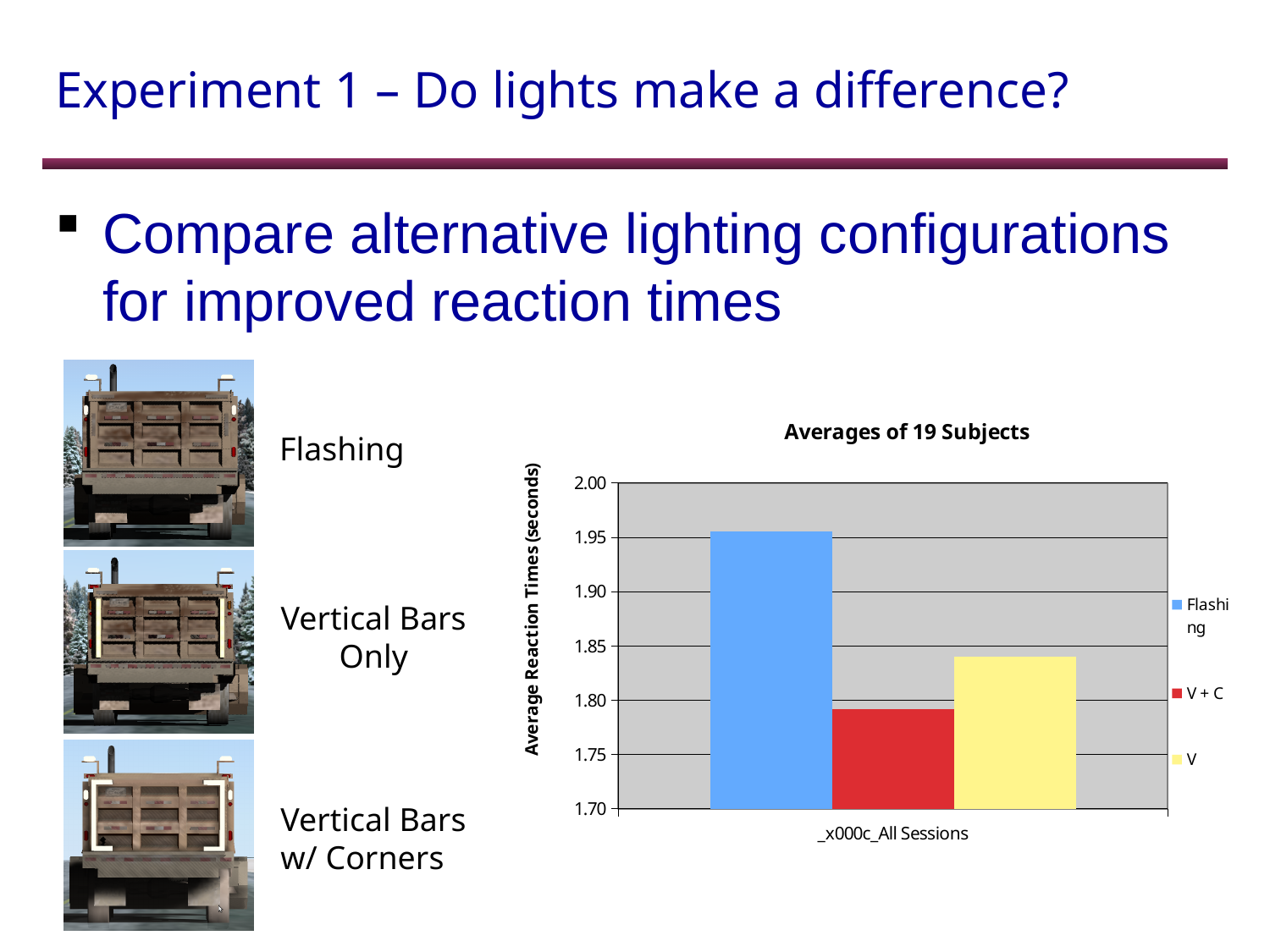
What kind of chart is shown on the slide? bar chart Is the value for Flashing greater or less than 1.90? greater Which has a larger average reaction time, Flashing or V? Flashing Which series has the highest average reaction time in the chart? Flashing What is the title of the chart? Averages of 19 Subjects Which series has the lowest average reaction time in the chart? V + C What is the label of the vertical axis of the chart? Average Reaction Times (seconds) How many bars are plotted in the chart? 3 How many series does the chart legend list? 3 Which has a larger average reaction time, V or V + C? V